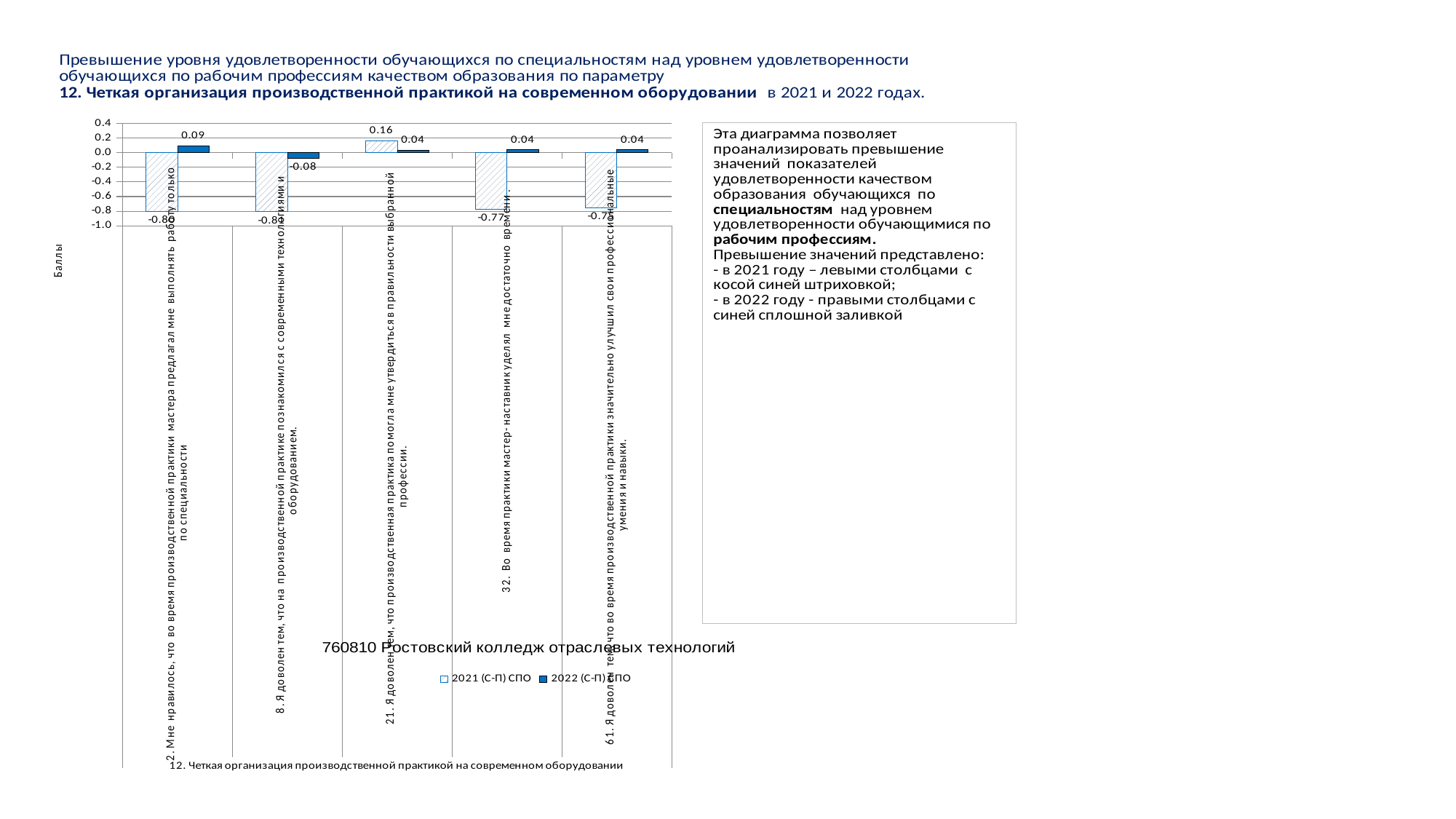
How many categories (questions) are plotted on the x axis of the chart? 5 What kind of chart is shown on the slide? bar chart How many series does the chart legend list? 2 For question 21, which series has the larger value, 2021 (С-П) СПО or 2022 (С-П) СПО? 2021 (С-П) СПО Which category has the highest 2021 (С-П) СПО value? 21. Я доволен тем, что производственная практика помогла мне утвердиться в правильности выбранной профессии What is the 2021 (С-П) СПО value for question 32 ("Во время практики мастер-наставник уделял мне достаточно времени")? -0.77 Which category has the lowest 2022 (С-П) СПО value? 8. Я доволен тем, что на производственной практике познакомился с современными технологиями и оборудованием What is the 2022 (С-П) СПО value for question 8 ("Я доволен тем, что на производственной практике познакомился с современными технологиями и оборудованием")? -0.08 For question 21, what is the difference between the 2021 (С-П) СПО value and the 2022 (С-П) СПО value? 0.12 Is the 2021 (С-П) СПО value for question 2 greater or less than -0.6? less What is the 2021 (С-П) СПО value for question 21 ("Я доволен тем, что производственная практика помогла мне утвердиться в правильности выбранной профессии")? 0.16 What is the 2022 (С-П) СПО value for question 2 ("Мне нравилось, что во время производственной практики мастера предлагал мне выполнять работу только по специальности")? 0.09